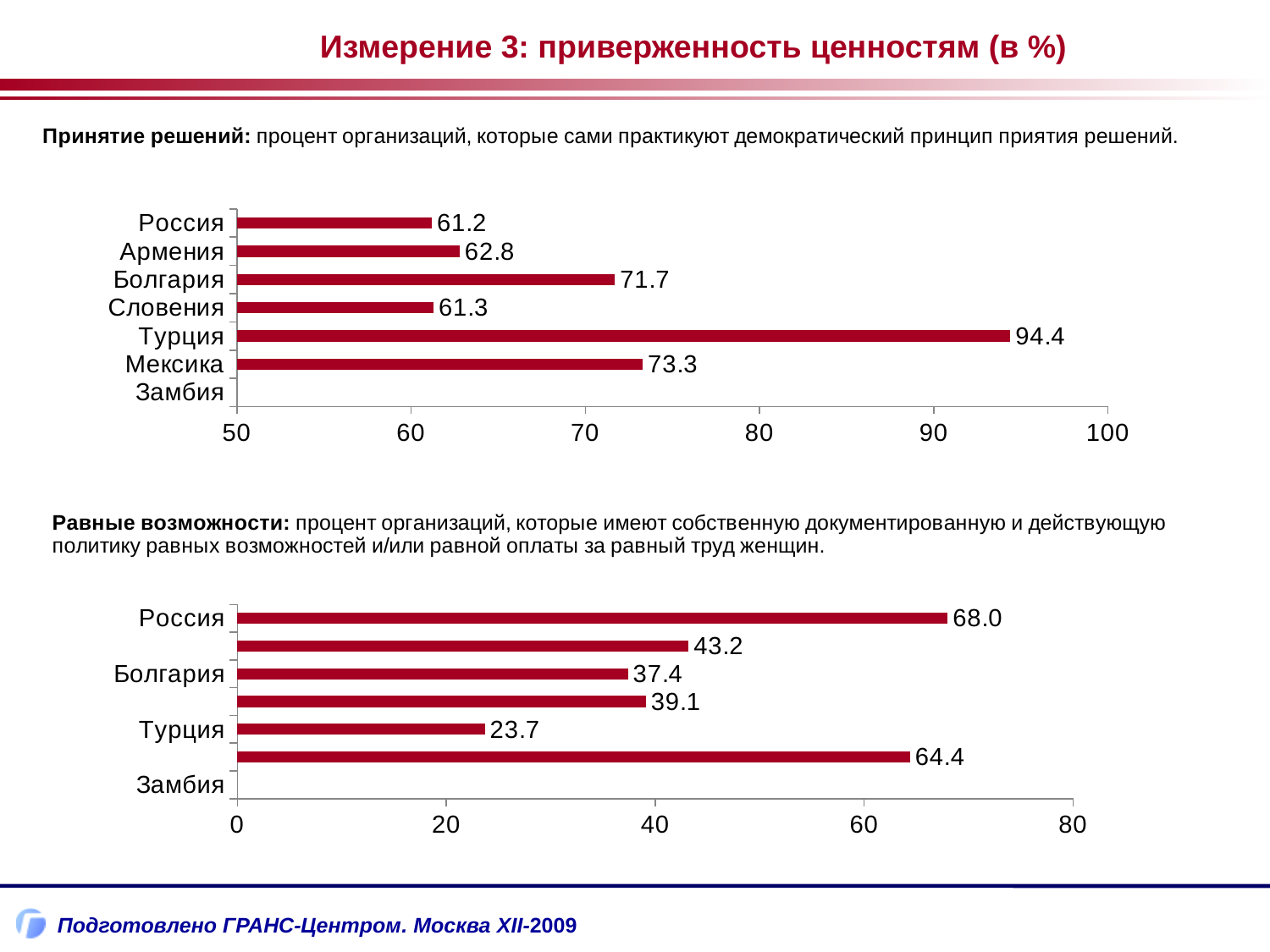
In the top chart (Принятие решений), which is larger, the value for Армения or the value for Словения? Армения In the top chart (Принятие решений), what is the difference between the values for Мексика and Россия? 12.1 What kind of chart is the top chart (Принятие решений)? bar chart In the top chart (Принятие решений), which country has the highest value? Турция In the top chart (Принятие решений), what is the value for Турция? 94.4 In the bottom chart (Равные возможности), what is the value for Турция? 23.7 In the bottom chart (Равные возможности), what is the difference between the values for Россия and Болгария? 30.6 In the top chart (Принятие решений), how many country categories are listed on the axis? 7 In the bottom chart (Равные возможности), which is larger, the value for Болгария or the value for Турция? Болгария In the bottom chart (Равные возможности), is the value for Россия greater or less than 60? greater In the top chart (Принятие решений), what is the value for Болгария? 71.7 In the bottom chart (Равные возможности), what is the value for Россия? 68.0